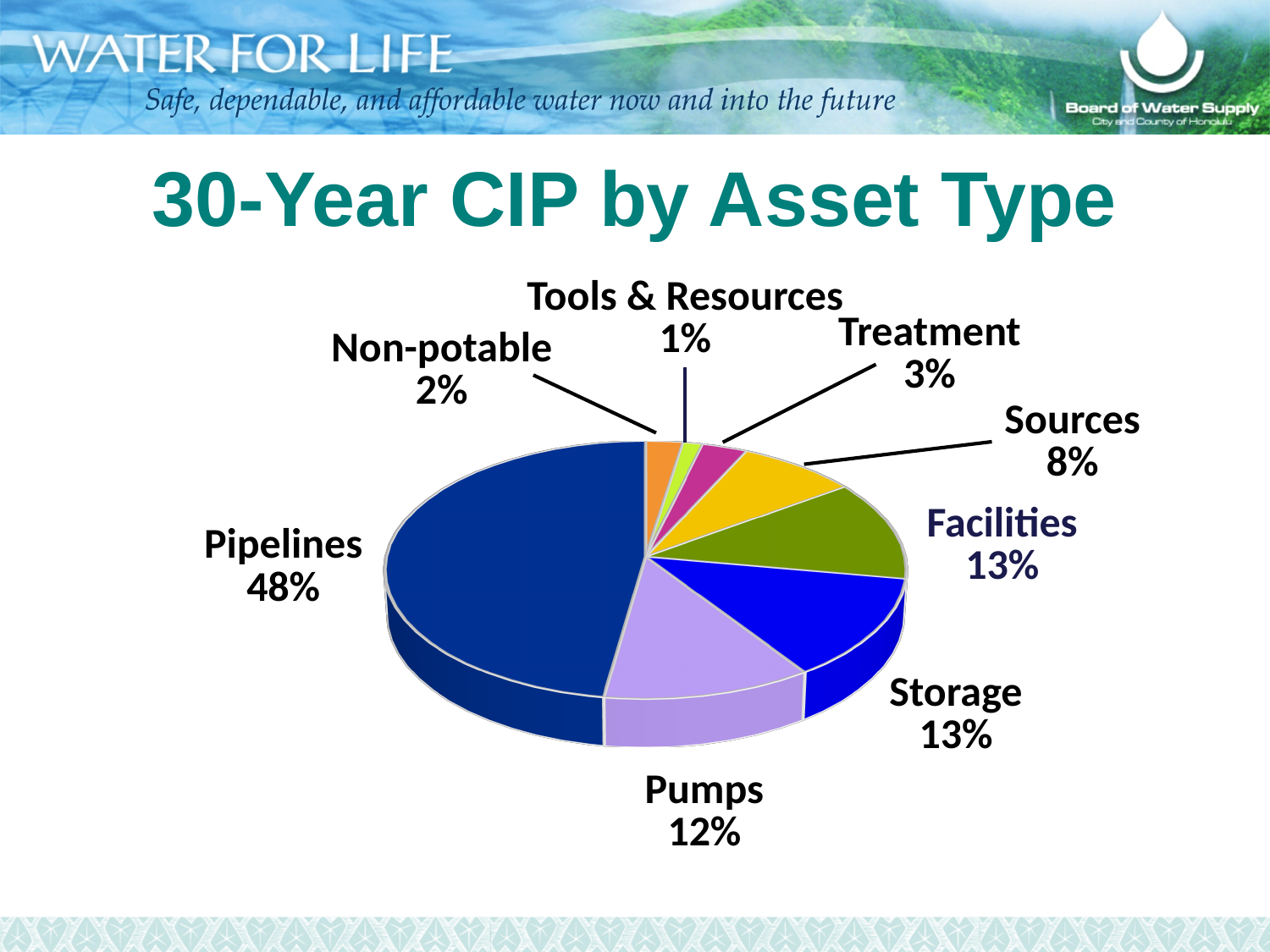
Which has a larger share, Sources or Treatment? Sources What kind of chart is shown on the slide? pie chart What is the combined share of Facilities and Storage? 26% Which asset type has the largest share of the 30-Year CIP? Pipelines How many asset types are shown in the pie chart? 8 What percentage is shown for Pumps? 12% What percentage is shown for Non-potable? 2% What is the difference in percentage points between Pipelines and Storage? 35 What share of the 30-Year CIP goes to Pipelines? 48% What is the title of the chart on the slide? 30-Year CIP by Asset Type Which asset type has the smallest share of the 30-Year CIP? Tools & Resources What percentage is shown for Sources? 8%